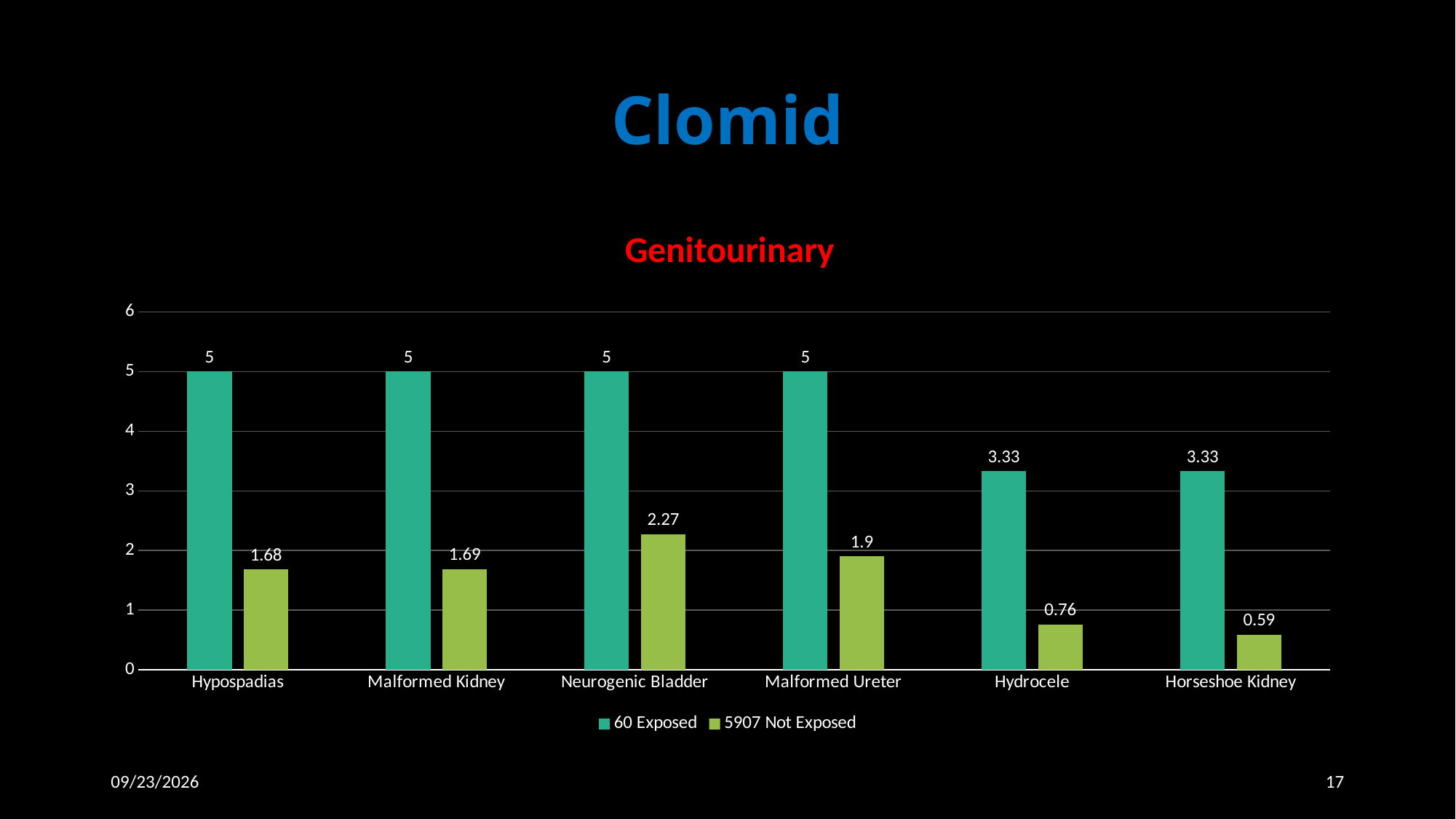
Which category has the highest value in the 5907 Not Exposed series? Neurogenic Bladder What is the title of the chart? Genitourinary What kind of chart is shown on the slide? Bar chart How many series does the legend list? 2 What is the value for Hypospadias in the 60 Exposed series? 5 Which category has the lowest value in the 5907 Not Exposed series? Horseshoe Kidney What is the value for Neurogenic Bladder in the 5907 Not Exposed series? 2.27 What is the value for Horseshoe Kidney in the 5907 Not Exposed series? 0.59 How many categories are shown on the x axis? 6 Which is larger for Hydrocele: the 60 Exposed value or the 5907 Not Exposed value? 60 Exposed What is the difference between the 60 Exposed and 5907 Not Exposed values for Malformed Ureter? 3.1 What is the value for Hydrocele in the 60 Exposed series? 3.33